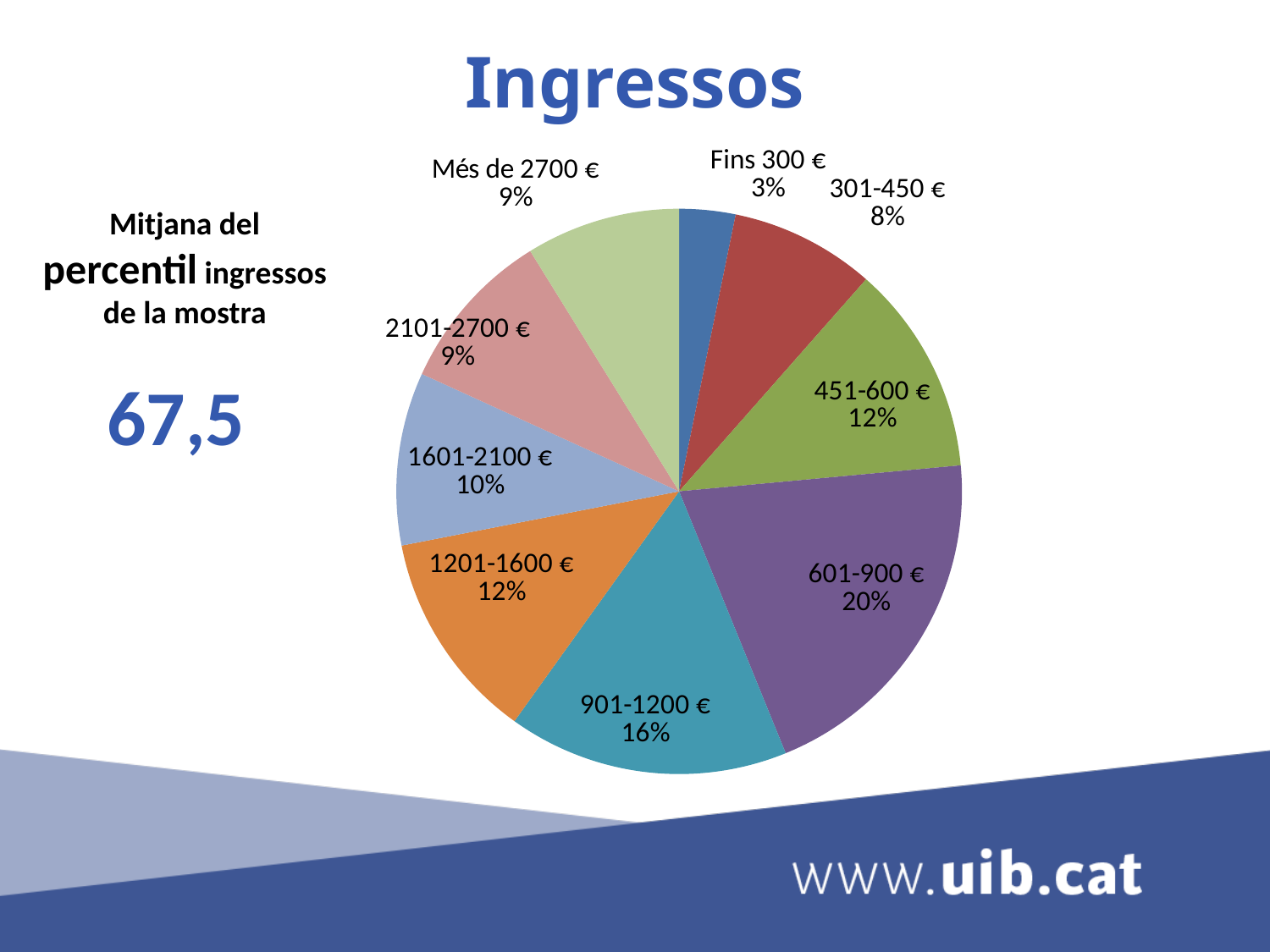
What is the value shown for the Fins 300 € category? 3% Which income category has the smallest slice of the pie? Fins 300 € Which is larger, the 901-1200 € slice or the 1201-1600 € slice? 901-1200 € What share of the pie does the 901-1200 € slice represent? 16% What is the title of the chart? Ingressos What kind of chart is shown on the slide? pie chart Which income category has the largest slice of the pie? 601-900 € How many categories are shown in the pie chart? 9 What is the value shown for the 1601-2100 € category? 10% What share of the pie does the 601-900 € slice represent? 20% What is the difference in percentage points between the 601-900 € slice and the 301-450 € slice? 12 What is the value shown for the 2101-2700 € category? 9%